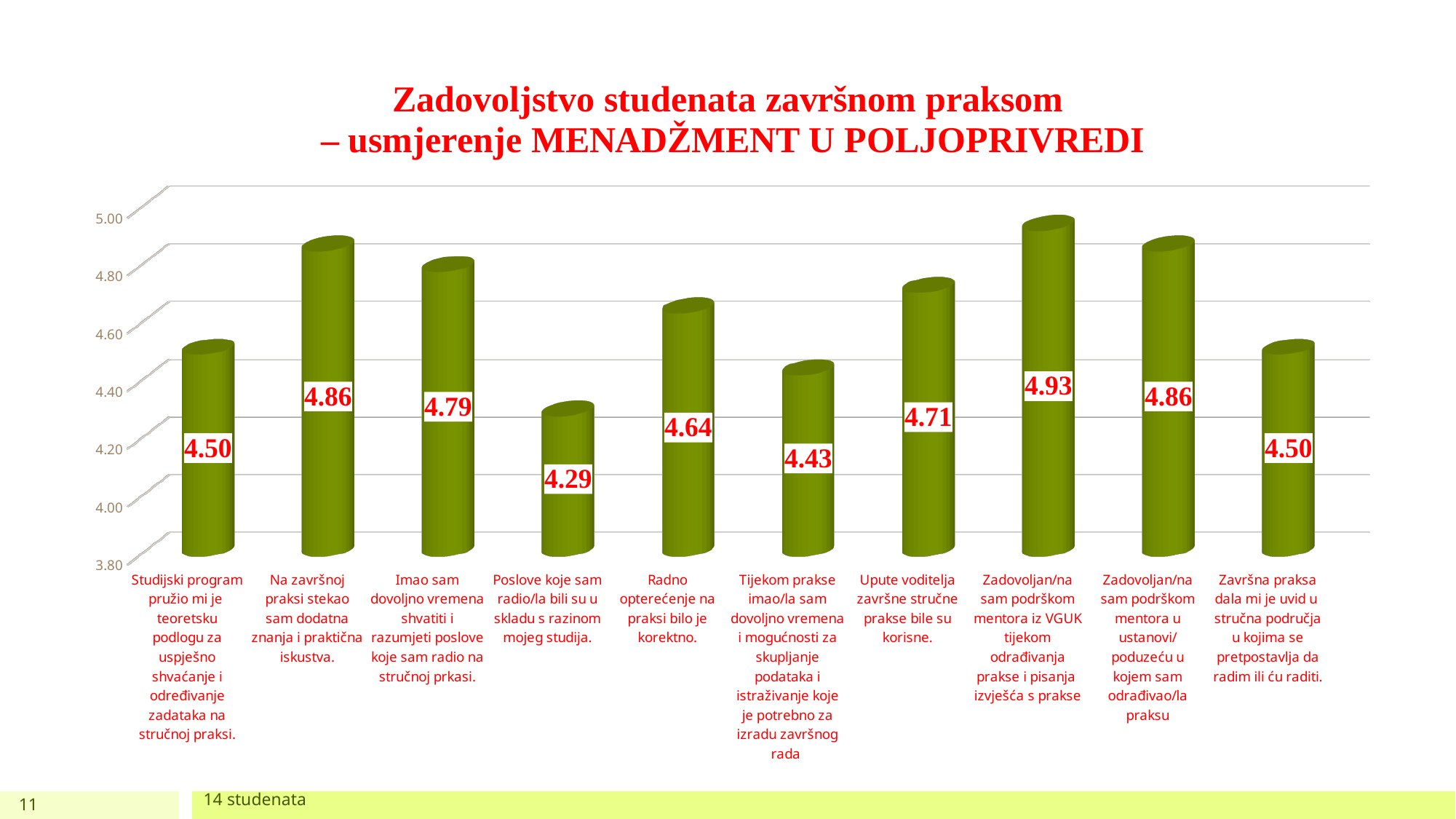
Which category has the highest value? Zadovoljan/na sam podrškom mentora iz VGUK tijekom odrađivanja prakse i pisanja izvješća s prakse Is the value for "Tijekom prakse imao/la sam dovoljno vremena i mogućnosti za skupljanje podataka i istraživanje koje je potrebno za izradu završnog rada" greater or less than 4.60? less What is the title of the chart? Zadovoljstvo studenata završnom praksom – usmjerenje MENADŽMENT U POLJOPRIVREDI What kind of chart is shown on the slide? bar chart What is the difference between the values for "Imao sam dovoljno vremena shvatiti i razumjeti poslove koje sam radio na stručnoj prkasi." and "Tijekom prakse imao/la sam dovoljno vremena i mogućnosti za skupljanje podataka i istraživanje koje je potrebno za izradu završnog rada"? 0.36 What is the value for "Radno opterećenje na praksi bilo je korektno."? 4.64 What is the value for "Poslove koje sam radio/la bili su u skladu s razinom mojeg studija."? 4.29 What is the difference between the highest value (4.93) and the lowest value (4.29)? 0.64 Which is larger: the value for "Radno opterećenje na praksi bilo je korektno." or the value for "Upute voditelja završne stručne prakse bile su korisne."? Upute voditelja završne stručne prakse bile su korisne. What is the value for "Upute voditelja završne stručne prakse bile su korisne."? 4.71 How many categories are shown in the chart? 10 Which category has the lowest value? Poslove koje sam radio/la bili su u skladu s razinom mojeg studija.